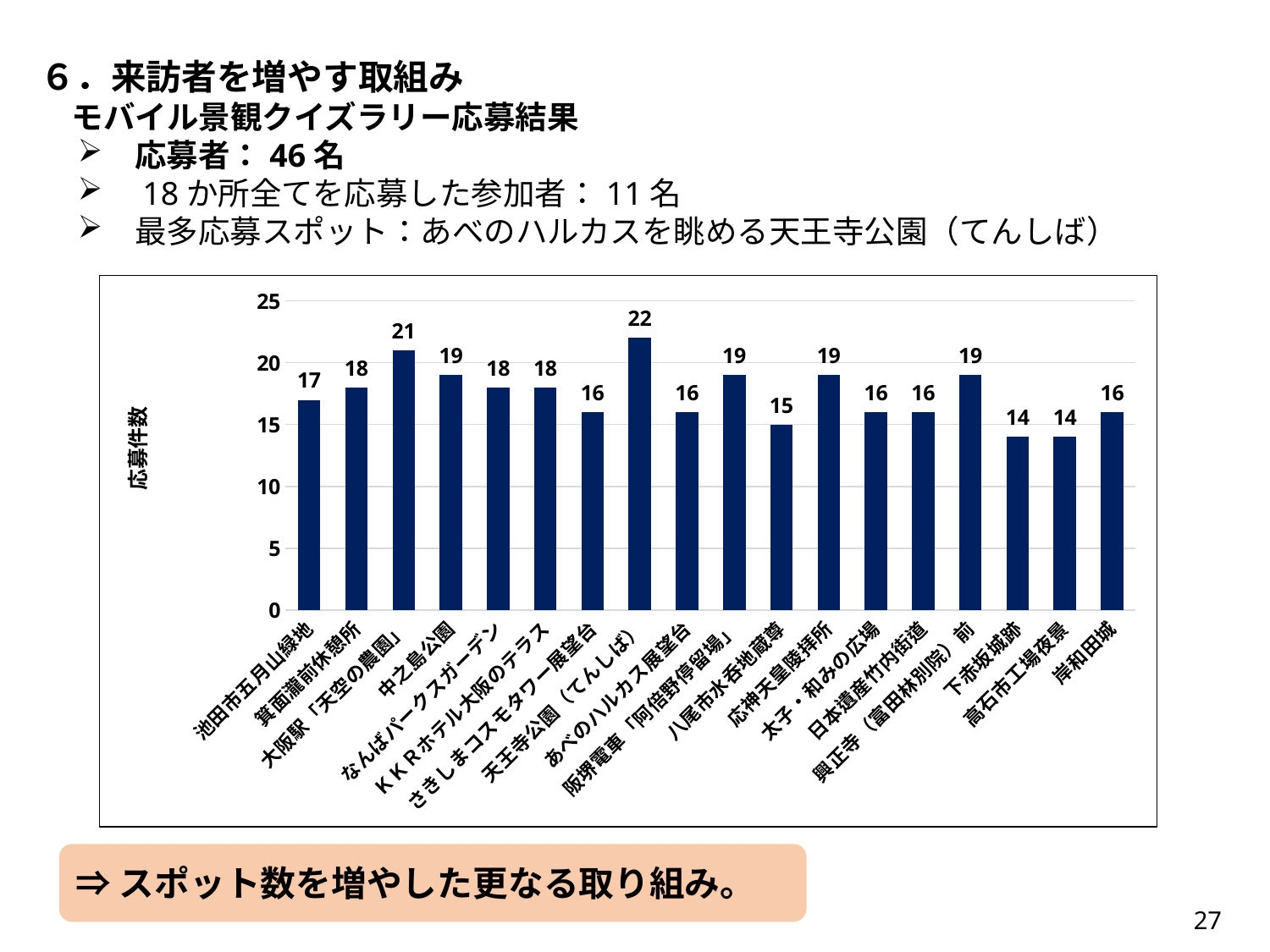
Which is larger, the value for 中之島公園 or the value for 太子・和みの広場? 中之島公園 What is the difference between the values for 天王寺公園（てんしば） and 下赤坂城跡? 8 What is the value for 天王寺公園（てんしば）? 22 What is the label on the vertical axis of the chart? 応募件数 How many spots (categories) are plotted in the chart? 18 What is the value for 八尾市水呑地蔵尊? 15 What is the value for 岸和田城? 16 What type of chart is shown on the slide? bar chart What is the difference between the values for 大阪駅「天空の農園」 and 池田市五月山緑地? 4 Is the value for 高石市工場夜景 greater or less than 15? less What is the value for 大阪駅「天空の農園」? 21 Which spot has the highest number of 応募件数? 天王寺公園（てんしば）